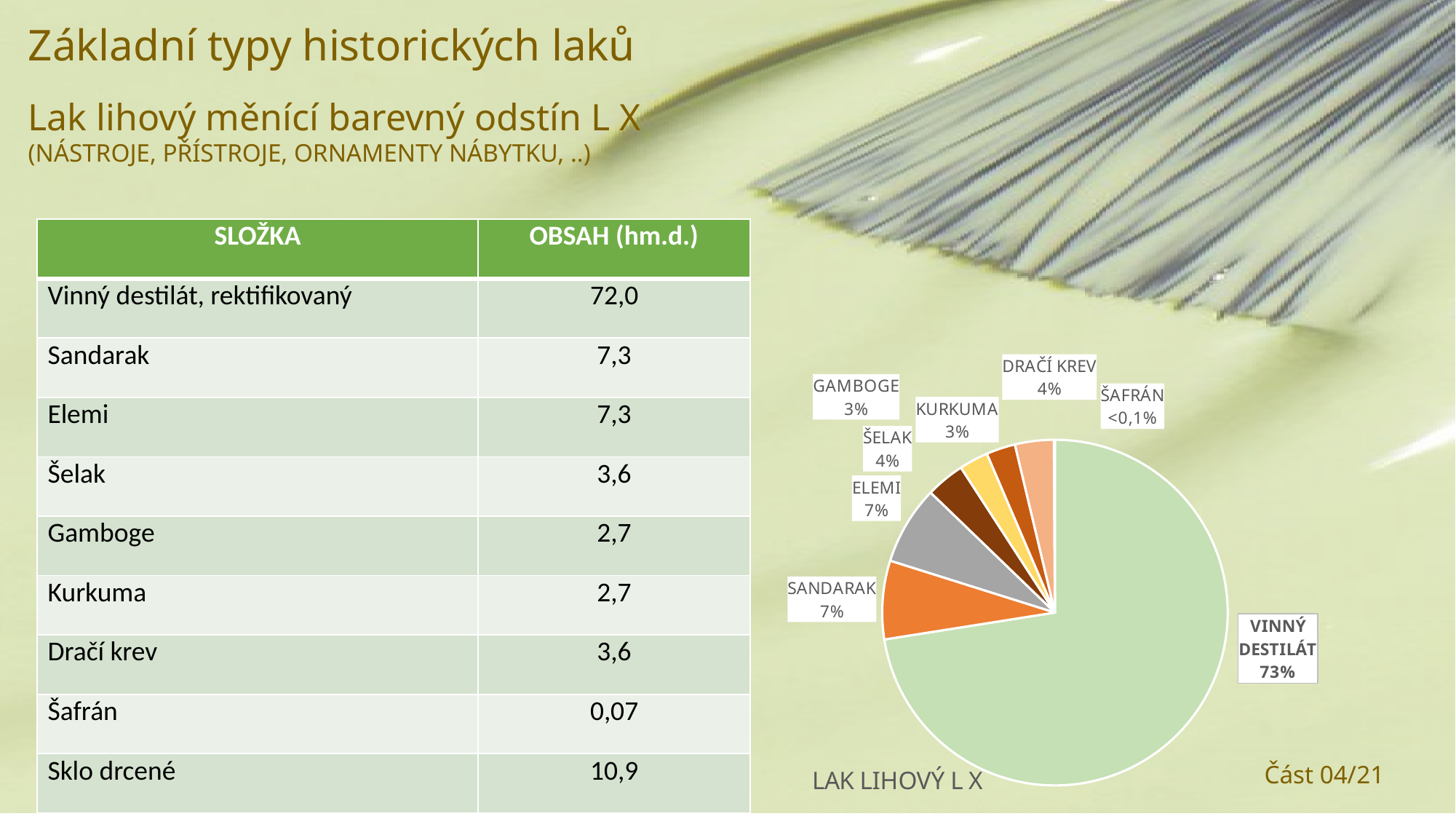
What is the title of the pie chart? LAK LIHOVÝ L X What share of the pie chart does GAMBOGE have? 3% Which is larger in the pie chart, the share of DRAČÍ KREV or the share of KURKUMA? DRAČÍ KREV What share of the pie chart does VINNÝ DESTILÁT have? 73% Which slice of the pie chart is the smallest? ŠAFRÁN What kind of chart is shown on the slide? pie chart How many slices does the pie chart have? 8 What value is shown for ŠAFRÁN in the pie chart? <0,1% What share of the pie chart does SANDARAK have? 7% What share of the pie chart does ŠELAK have? 4% What is the difference between the shares of VINNÝ DESTILÁT and ELEMI in the pie chart? 66% Which slice of the pie chart is the largest? VINNÝ DESTILÁT